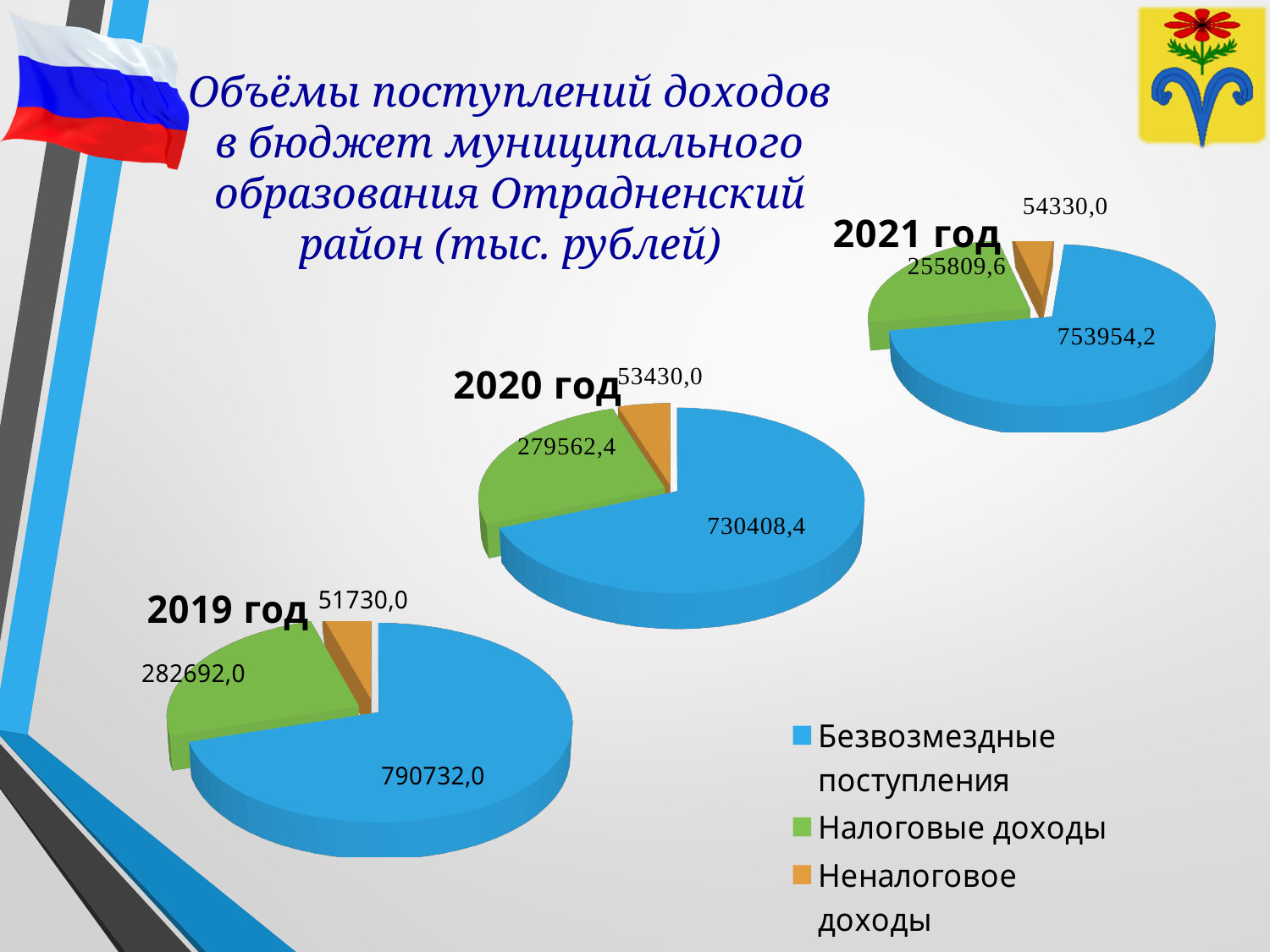
In the 2019 год pie chart, what is the value for Безвозмездные поступления? 790732,0 How many slices does each pie chart on the slide have? 3 In the 2020 год pie chart, what is the value for Налоговые доходы? 279562,4 Which is larger: Налоговые доходы in the 2019 год chart or Налоговые доходы in the 2021 год chart? 2019 год In the 2020 год pie chart, which category has the smallest slice? Неналоговое доходы In the 2021 год pie chart, what is the value for Неналоговое доходы? 54330,0 In the 2021 год pie chart, which category has the largest slice? Безвозмездные поступления How many entries does the legend list? 3 In the 2019 год pie chart, what is the difference between Безвозмездные поступления and Налоговые доходы? 508040,0 In the 2020 год pie chart, what is the difference between Налоговые доходы and Неналоговое доходы? 226132,4 What kind of charts are shown on the slide? Pie charts What is the total of all three slices in the 2019 год pie chart? 1125154,0